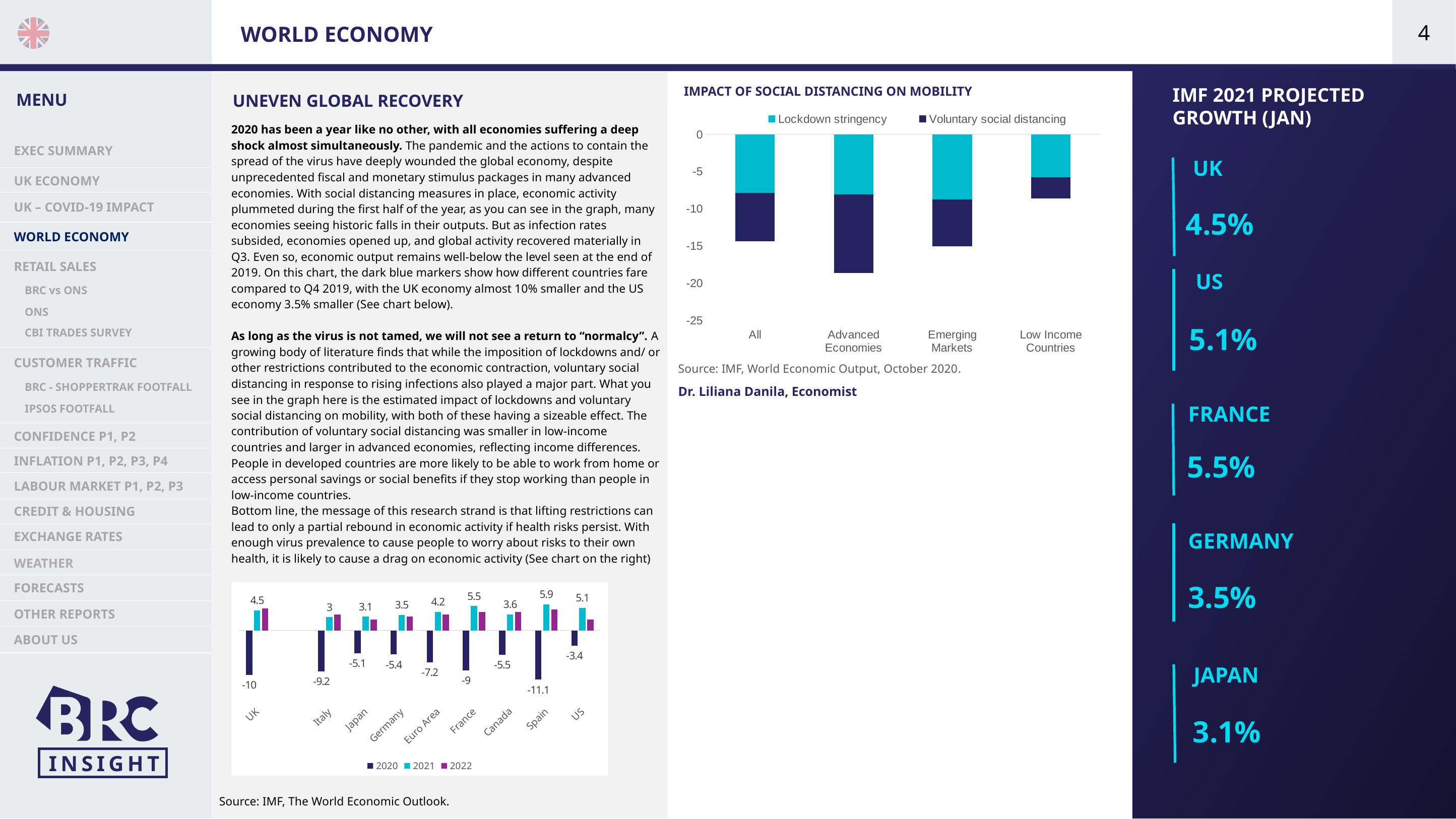
In the bottom-left chart, what is the difference between the 2021 values for the UK and Italy? 1.5 In the bottom-left chart, what is the 2021 value for France? 5.5 In the bottom-left chart, which country has the lowest 2020 value? Spain In the bottom-left chart, what is the 2020 value for the US? -3.4 In the 'Impact of Social Distancing on Mobility' chart, is the total stacked value for Advanced Economies greater or less than -15? less How many countries or regions are shown on the x axis of the bottom-left chart? 9 How many series does the legend of the bottom-left chart list? 3 In the bottom-left chart, which country has the highest 2021 value? Spain In the bottom-left chart, which has the larger 2021 value, Germany or Canada? Canada What type of chart is the 'Impact of Social Distancing on Mobility' chart? Stacked bar chart In the 'Impact of Social Distancing on Mobility' chart, which two series does the legend list? Lockdown stringency and Voluntary social distancing In the bottom-left chart, what is the 2020 value for Spain? -11.1